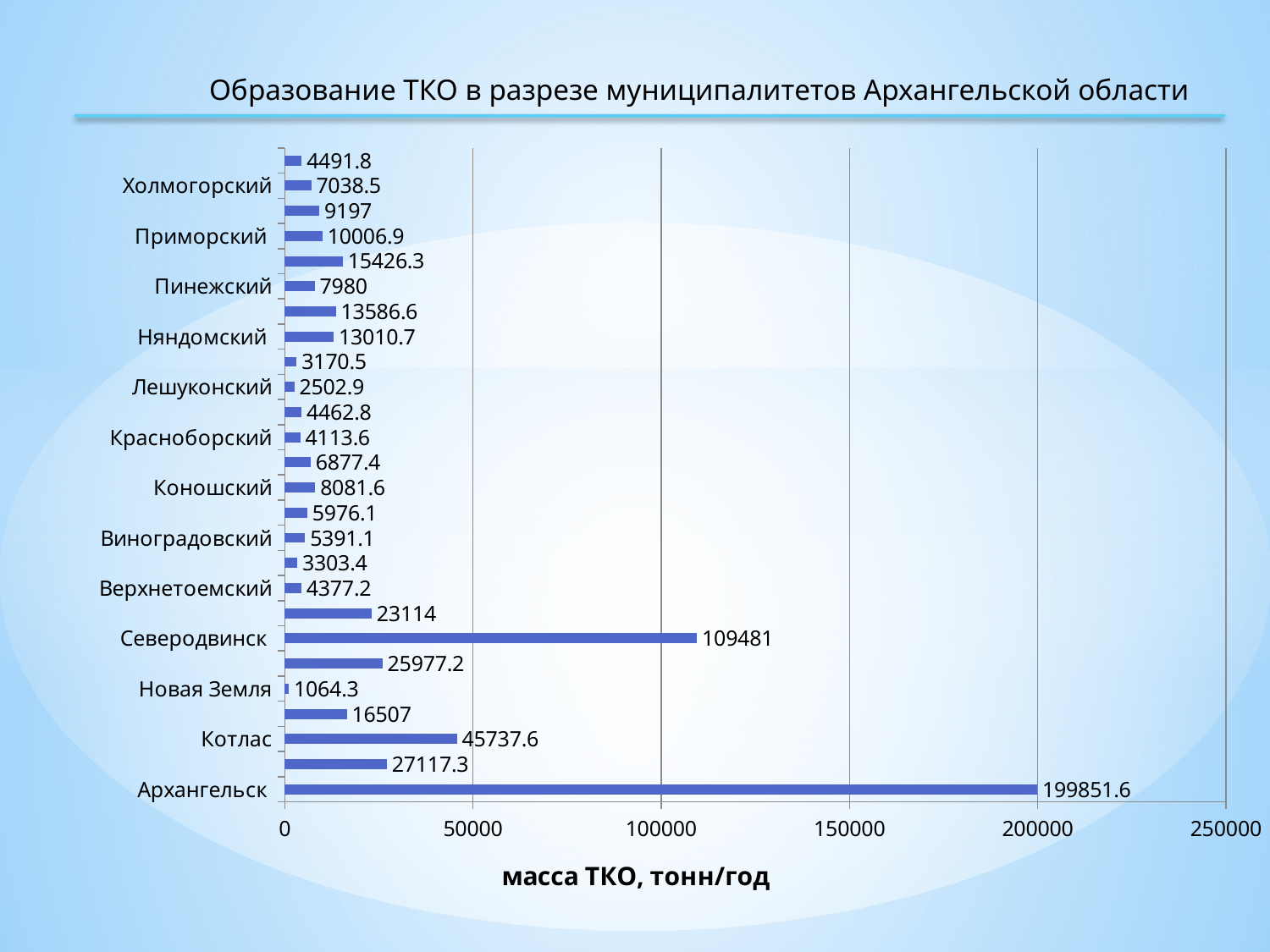
What is the difference between the values for Архангельск and Северодвинск? 90370.6 What is the value for Архангельск? 199851.6 What is the title of the horizontal axis? масса ТКО, тонн/год Which labelled municipality has the lowest value? Новая Земля What is the value for Новая Земля? 1064.3 What is the value for Котлас? 45737.6 Which municipality has the highest value? Архангельск Which is larger, the value for Няндомский or for Пинежский? Няндомский What kind of chart is shown? bar chart What is the value for Северодвинск? 109481 What is the value for Няндомский? 13010.7 Is the value for Северодвинск greater or less than 100000? greater